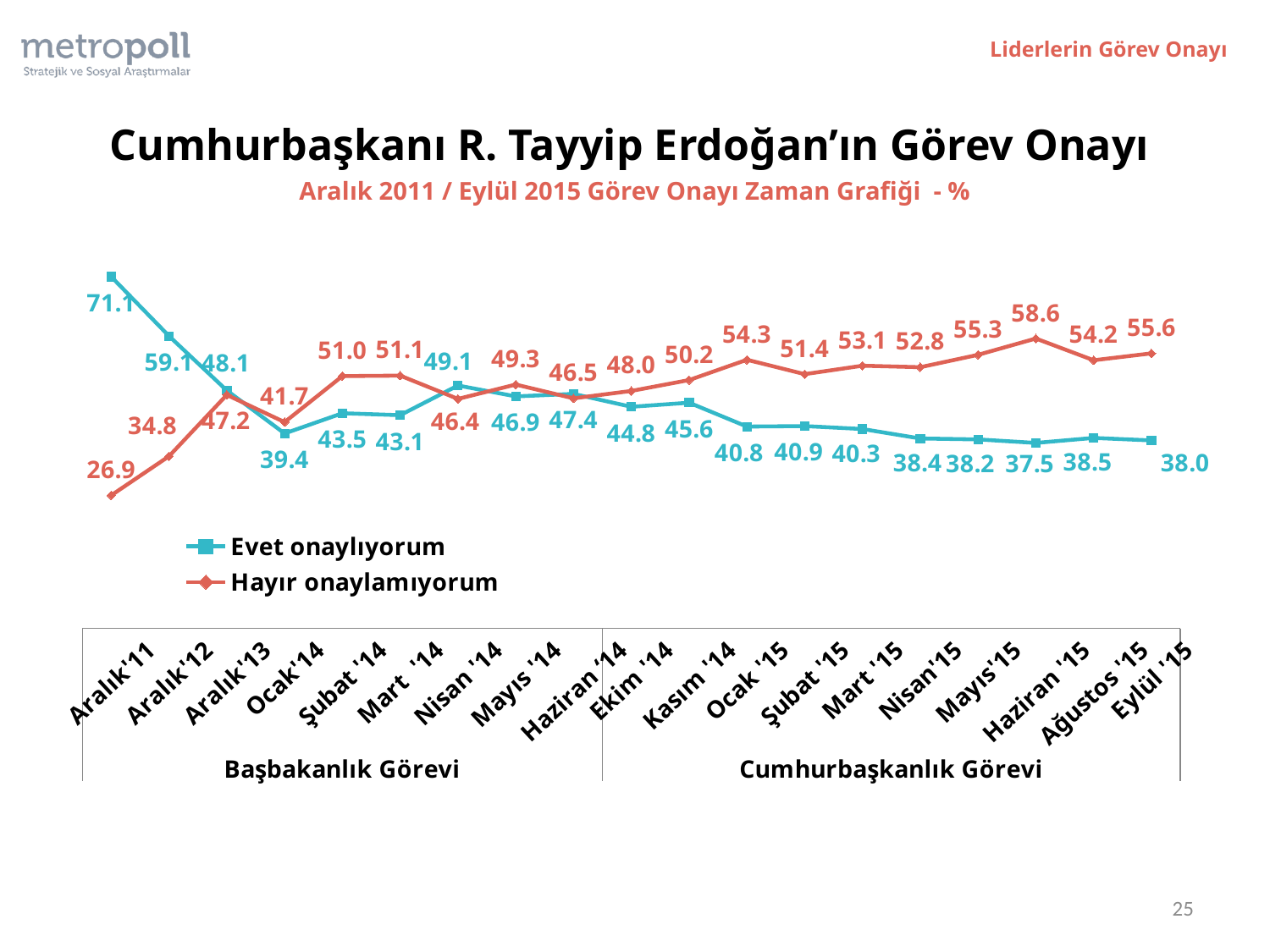
What are the two series names listed in the legend? Evet onaylıyorum; Hayır onaylamıyorum In which period does the 'Hayır onaylamıyorum' series reach its highest value? Haziran '15 What is the value of the 'Hayır onaylamıyorum' series at Eylül '15? 55.6 How many series does the legend list? 2 How many time periods are plotted on the x axis? 19 What is the value of the 'Evet onaylıyorum' series at Aralık'11? 71.1 At Ocak '15, which series has the higher value, 'Evet onaylıyorum' or 'Hayır onaylamıyorum'? Hayır onaylamıyorum In which period does the 'Evet onaylıyorum' series reach its lowest value? Haziran '15 Does the 'Evet onaylıyorum' series generally rise or fall from Aralık'11 to Eylül '15? Fall What is the difference between the 'Evet onaylıyorum' values at Aralık'11 and Aralık'12? 12.0 What kind of chart is shown on the slide? Line chart What is the value of the 'Hayır onaylamıyorum' series at Aralık'11? 26.9